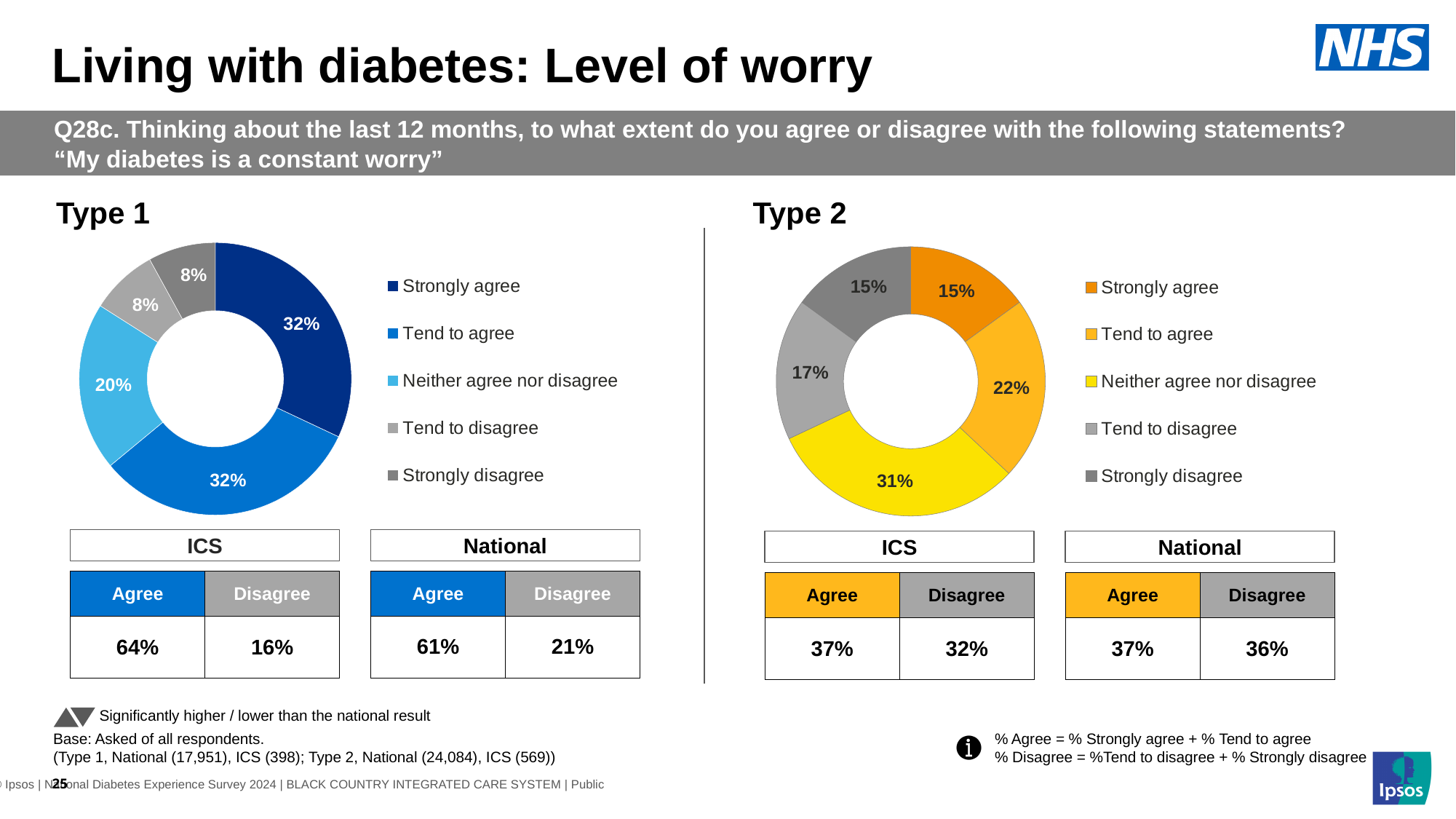
In the Type 2 chart, which response category has the largest share? Neither agree nor disagree In the Type 2 chart, what is the difference between the share for Neither agree nor disagree and the share for Strongly agree? 16 percentage points In the Type 1 chart, which is larger: the share for Strongly agree or the share for Strongly disagree? Strongly agree In the Type 1 chart, what is the difference between the share for Neither agree nor disagree and the share for Tend to disagree? 12 percentage points How many response categories does the Type 1 chart's legend list? 5 In the Type 2 chart, what colour represents Neither agree nor disagree? Yellow In the Type 2 chart, what percentage of respondents said they tend to agree? 22% What kind of chart is used for the Type 2 results? Donut (pie) chart In the Type 1 chart, what percentage of respondents said they strongly agree? 32% In the Type 2 chart, which is larger: the share for Tend to agree or the share for Tend to disagree? Tend to agree In the Type 2 chart, what percentage of respondents said they tend to disagree? 17% In the Type 1 chart, what percentage of respondents neither agree nor disagree? 20%